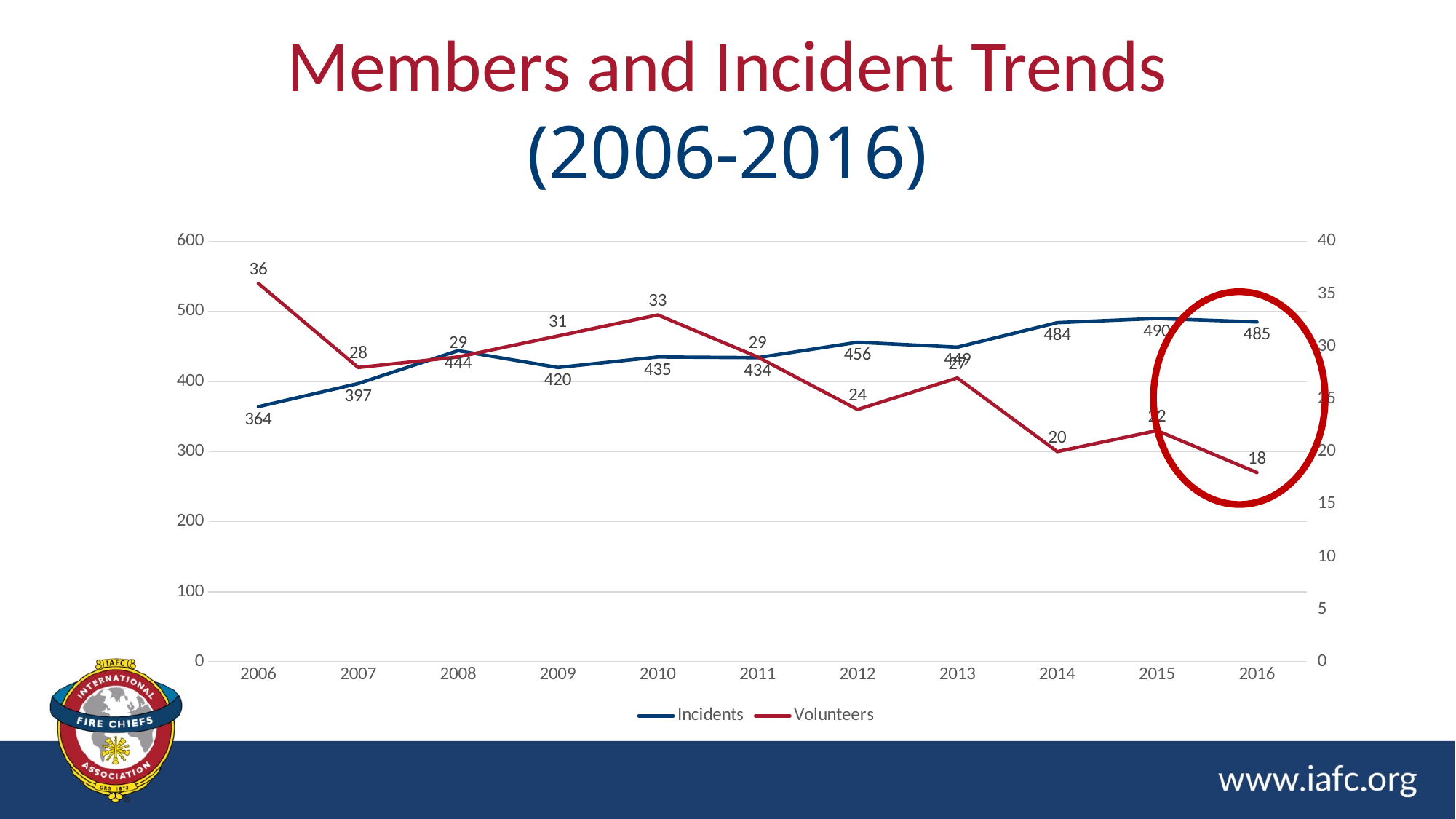
What kind of chart is shown on the slide? Line chart What is the value for Volunteers in 2010? 33 How many series does the legend list? 2 Which is larger, the Incidents value in 2008 or in 2009? 2008 In which year is the Volunteers value lowest? 2016 What is the difference between the Volunteers values in 2006 and 2016? 18 What is the value for Incidents in 2014? 484 Does the Volunteers series generally rise or fall from 2006 to 2016? Fall What is the value for Incidents in 2006? 364 What is the value for Volunteers in 2016? 18 How many years are plotted on the x axis? 11 In which year is the Incidents value highest? 2015